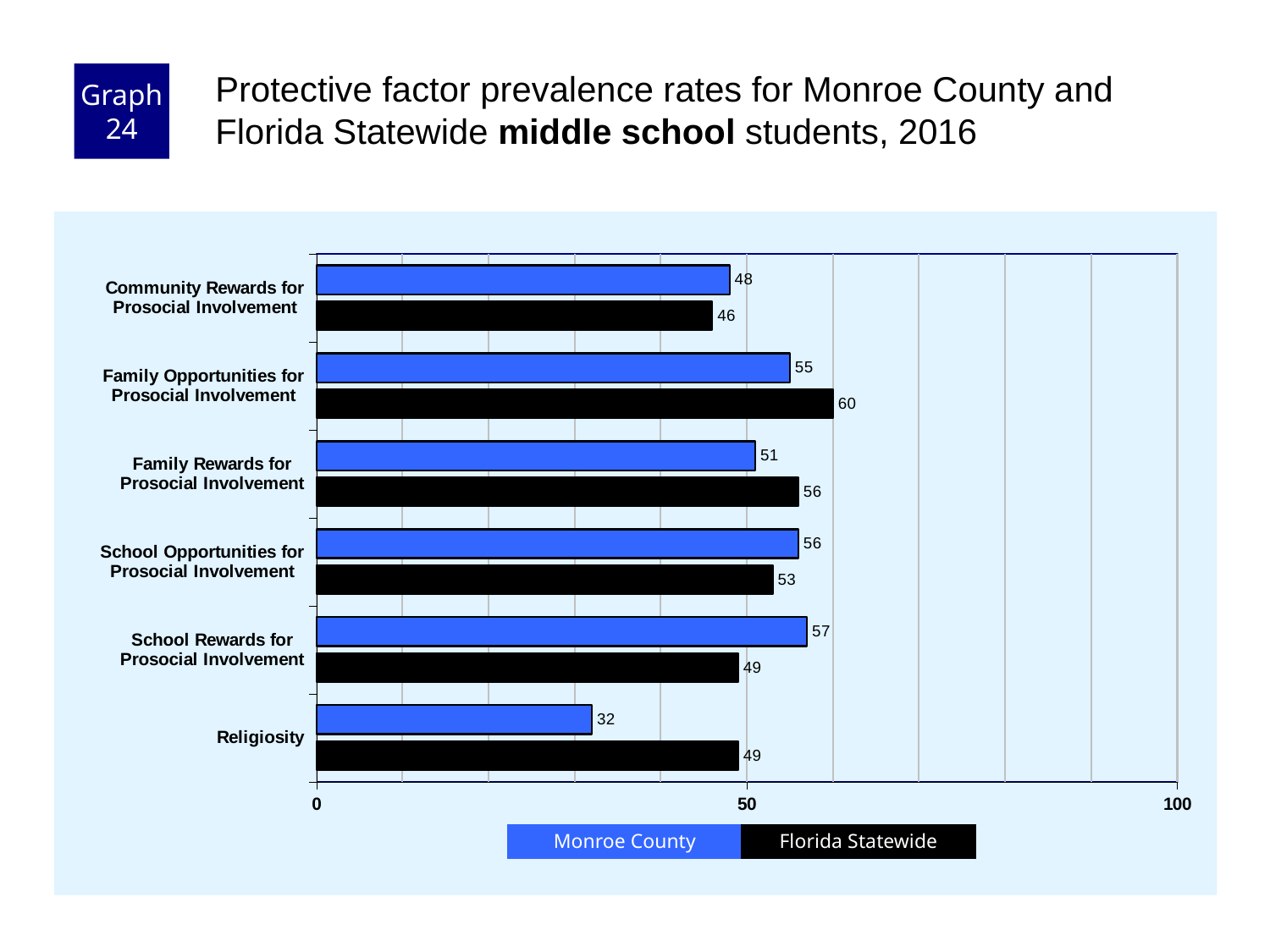
What is the Florida Statewide value for Family Opportunities for Prosocial Involvement? 60 What is the Monroe County value for Religiosity? 32 Which category has the highest Florida Statewide value? Family Opportunities for Prosocial Involvement How many series does the legend list? 2 For School Opportunities for Prosocial Involvement, which is larger: Monroe County or Florida Statewide? Monroe County How many categories are shown on the chart? 6 Which category has the highest Monroe County value? School Rewards for Prosocial Involvement Which category has the lowest Monroe County value? Religiosity Is the Monroe County value for Religiosity greater or less than 50? less What is the Monroe County value for School Rewards for Prosocial Involvement? 57 What is the difference between the Florida Statewide and Monroe County values for Religiosity? 17 What kind of chart is shown on the slide? bar chart